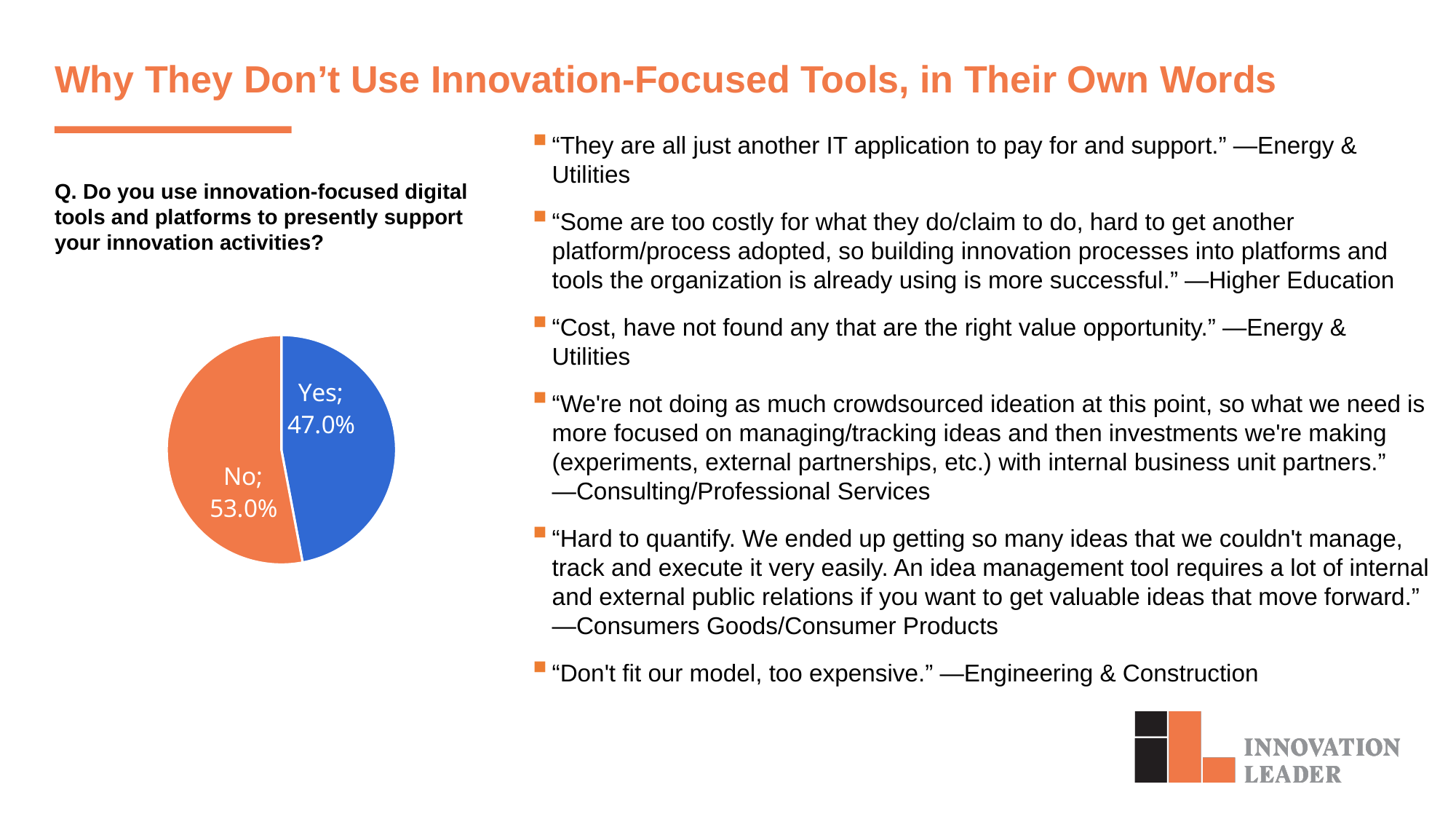
Which response has the smaller share of the pie chart? Yes Which response has the larger share of the pie chart? No How many slices does the pie chart have? 2 What colour is the No slice of the pie chart? orange What is the difference in percentage points between the No and Yes slices? 6.0% What percentage of respondents answered No in the pie chart? 53.0% What percentage of respondents answered Yes in the pie chart? 47.0% Is the value for No greater or less than 50%? greater Is the share for Yes larger or smaller than the share for No? smaller What colour is the Yes slice of the pie chart? blue What type of chart is shown on the slide? pie chart